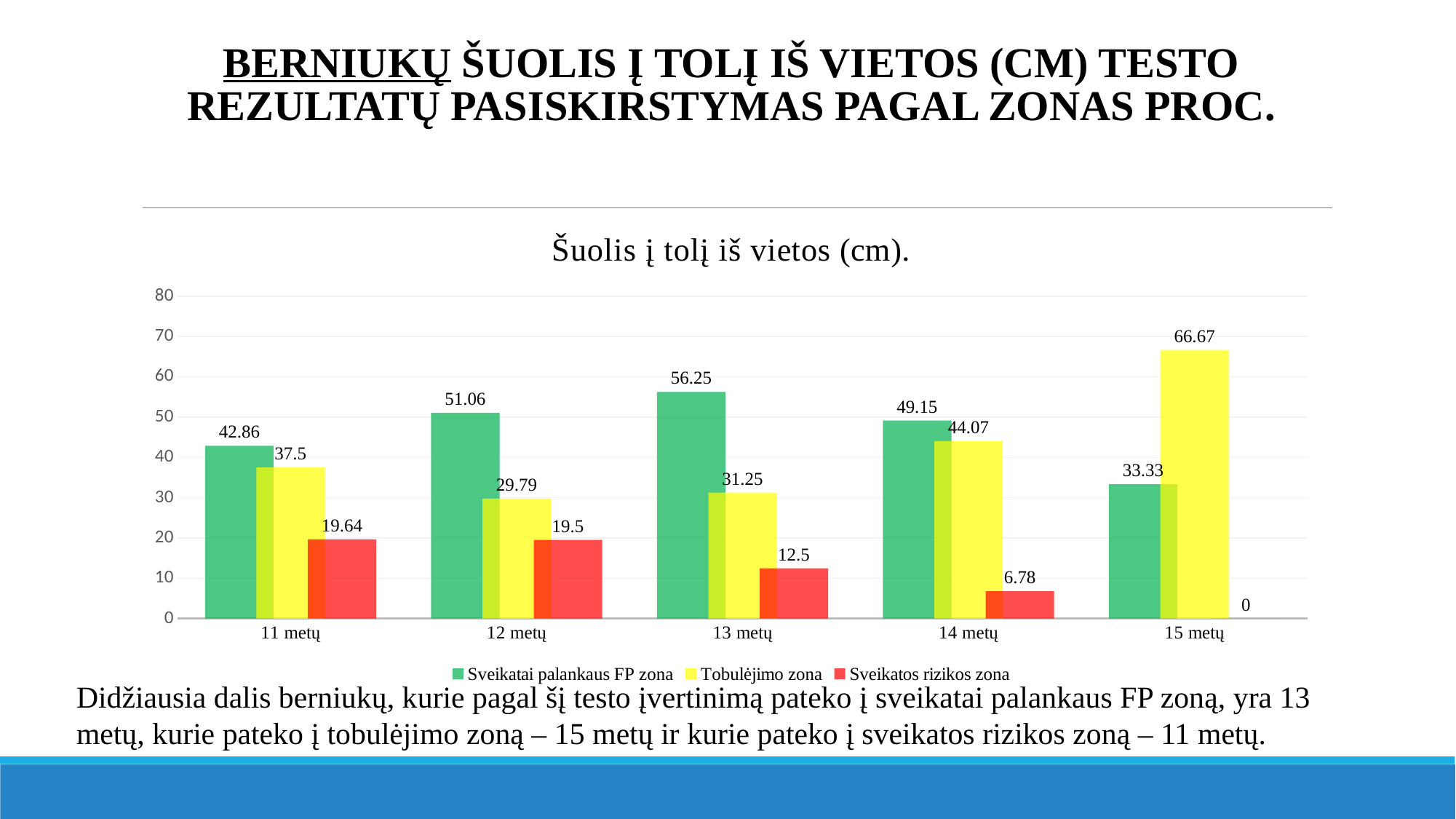
What is the value for Tobulėjimo zona at 15 metų? 66.67 Which age group has the lowest value for Sveikatos rizikos zona? 15 metų Which age group has the highest value for Sveikatai palankaus FP zona? 13 metų What is the value for Sveikatos rizikos zona at 15 metų? 0 What is the value for Sveikatos rizikos zona at 11 metų? 19.64 What kind of chart is shown on the slide? Bar chart What is the title of the chart? Šuolis į tolį iš vietos (cm). How many series does the legend list? 3 How many age groups are shown on the x axis? 5 What is the value for Sveikatai palankaus FP zona at 13 metų? 56.25 Which is larger at 14 metų: Sveikatai palankaus FP zona or Tobulėjimo zona? Sveikatai palankaus FP zona What is the difference between Sveikatai palankaus FP zona and Tobulėjimo zona at 12 metų? 21.27